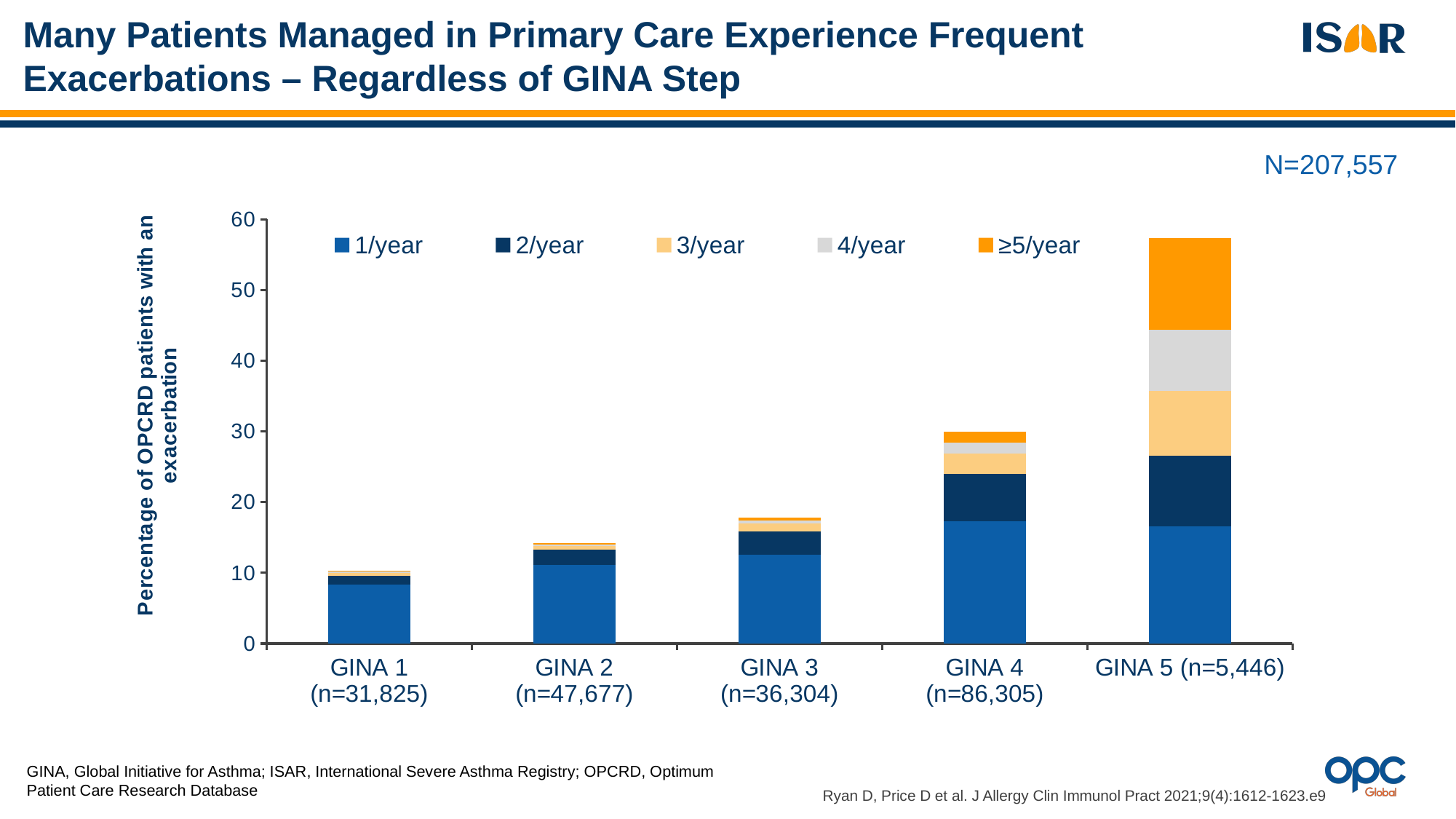
What kind of chart is shown on the slide? Stacked bar chart What is the sample size (n) shown for GINA 4? n=86,305 Is the total stacked bar for GINA 2 greater or less than 10? greater Which has a larger total percentage of patients with an exacerbation, GINA 3 or GINA 4? GINA 4 Is the total stacked bar for GINA 4 greater or less than 40? less Is the total stacked bar for GINA 5 greater or less than 50? greater Which GINA step has the lowest total percentage of patients with an exacerbation? GINA 1 Which GINA step has the highest total percentage of patients with an exacerbation? GINA 5 How many GINA step categories are plotted on the x axis? 5 Do the total bar heights rise or fall from GINA 1 to GINA 5? Rise How many series does the legend list? 5